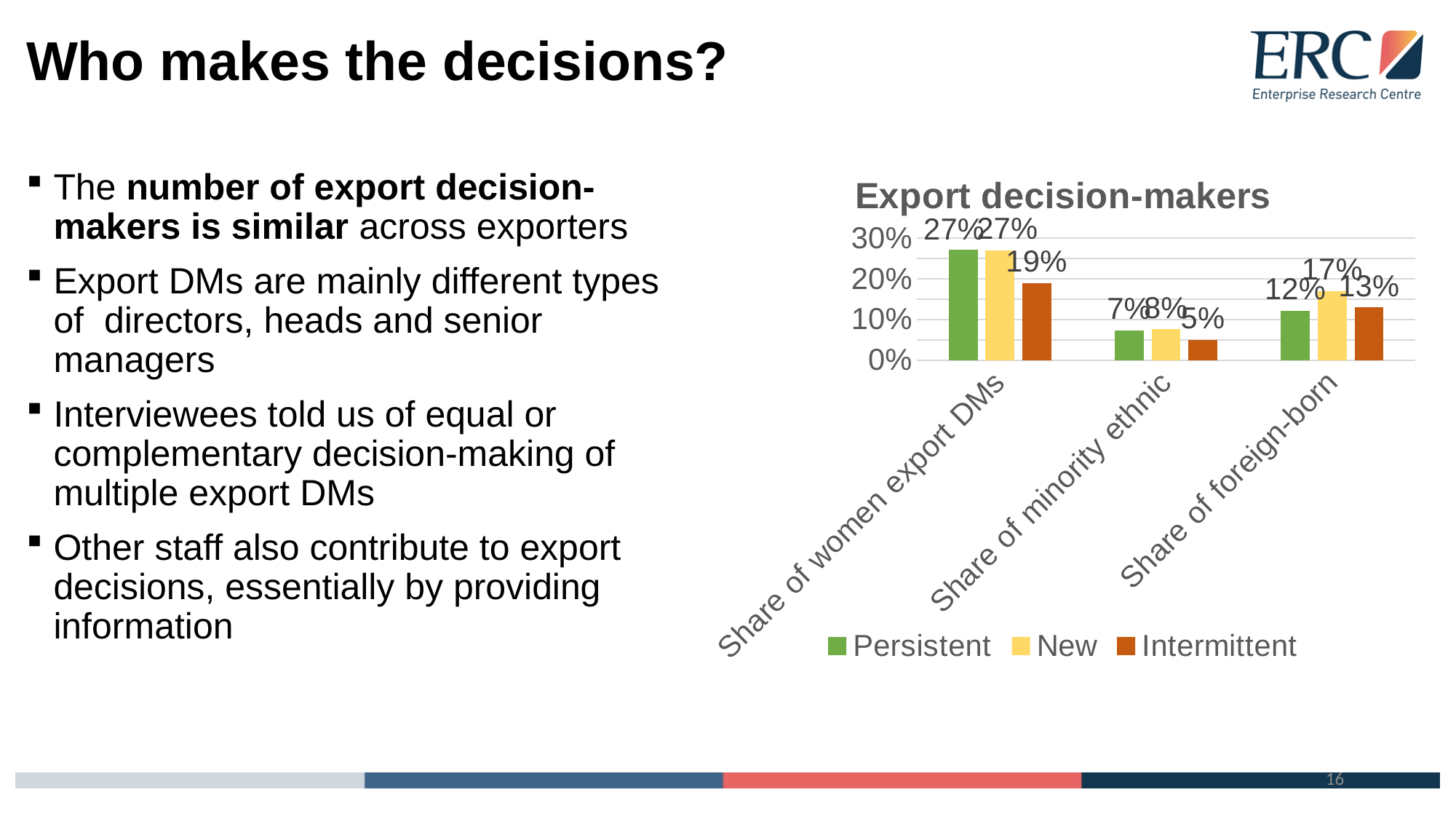
What is the value for Intermittent exporters in the 'Share of women export DMs' category? 19% What is the value for New exporters in the 'Share of foreign-born' category? 17% Is the Persistent value for 'Share of foreign-born' larger or smaller than the Persistent value for 'Share of minority ethnic'? larger Which series has the highest value in the 'Share of foreign-born' category? New Is the value for Intermittent exporters in 'Share of women export DMs' greater or less than 10%? greater What is the value for Intermittent exporters in the 'Share of minority ethnic' category? 5% What type of chart is shown on the slide? bar chart What is the value for Persistent exporters in the 'Share of women export DMs' category? 27% What is the difference between the Persistent and Intermittent values in the 'Share of women export DMs' category? 8% How many series does the legend list? 3 How many categories are shown on the x axis of the chart? 3 Which series has the lowest value in the 'Share of minority ethnic' category? Intermittent